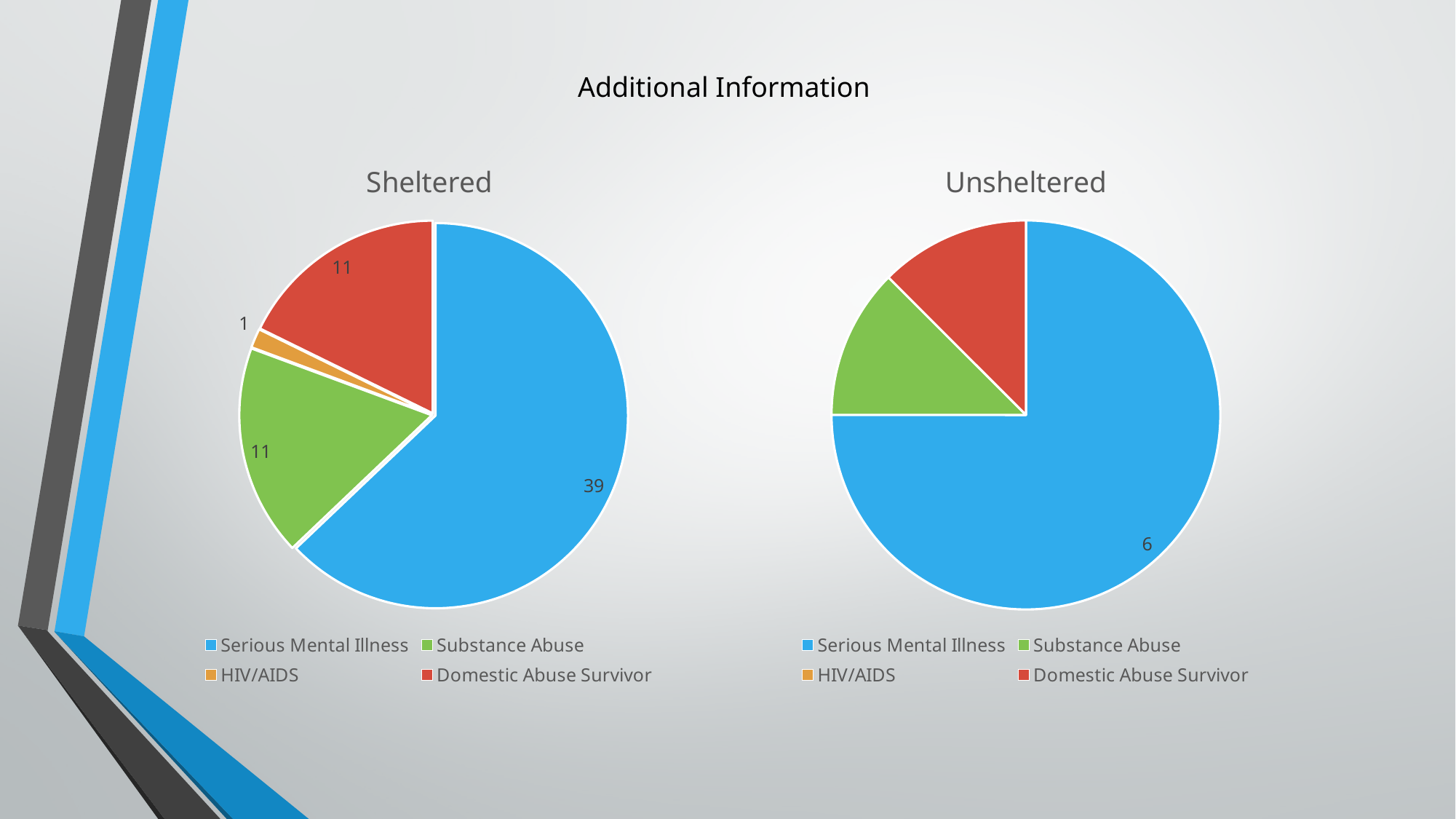
In the Sheltered pie chart, what is the difference between the Serious Mental Illness value and the Substance Abuse value? 28 In the Sheltered pie chart, what is the value for Domestic Abuse Survivor? 11 In the Sheltered pie chart, what is the value for HIV/AIDS? 1 In the Sheltered pie chart, what is the value for Serious Mental Illness? 39 In the Sheltered pie chart, what is the total of all the labelled slices? 62 How many categories does the legend of the Unsheltered chart list? 4 What kind of chart is the Sheltered chart? Pie chart In the Unsheltered pie chart, what is the value for Serious Mental Illness? 6 In the Sheltered pie chart, which category has the smallest slice? HIV/AIDS In the Unsheltered pie chart, which category has the largest slice? Serious Mental Illness In the Sheltered pie chart, which category has the largest slice? Serious Mental Illness In the Sheltered pie chart, which is larger: Serious Mental Illness or Domestic Abuse Survivor? Serious Mental Illness